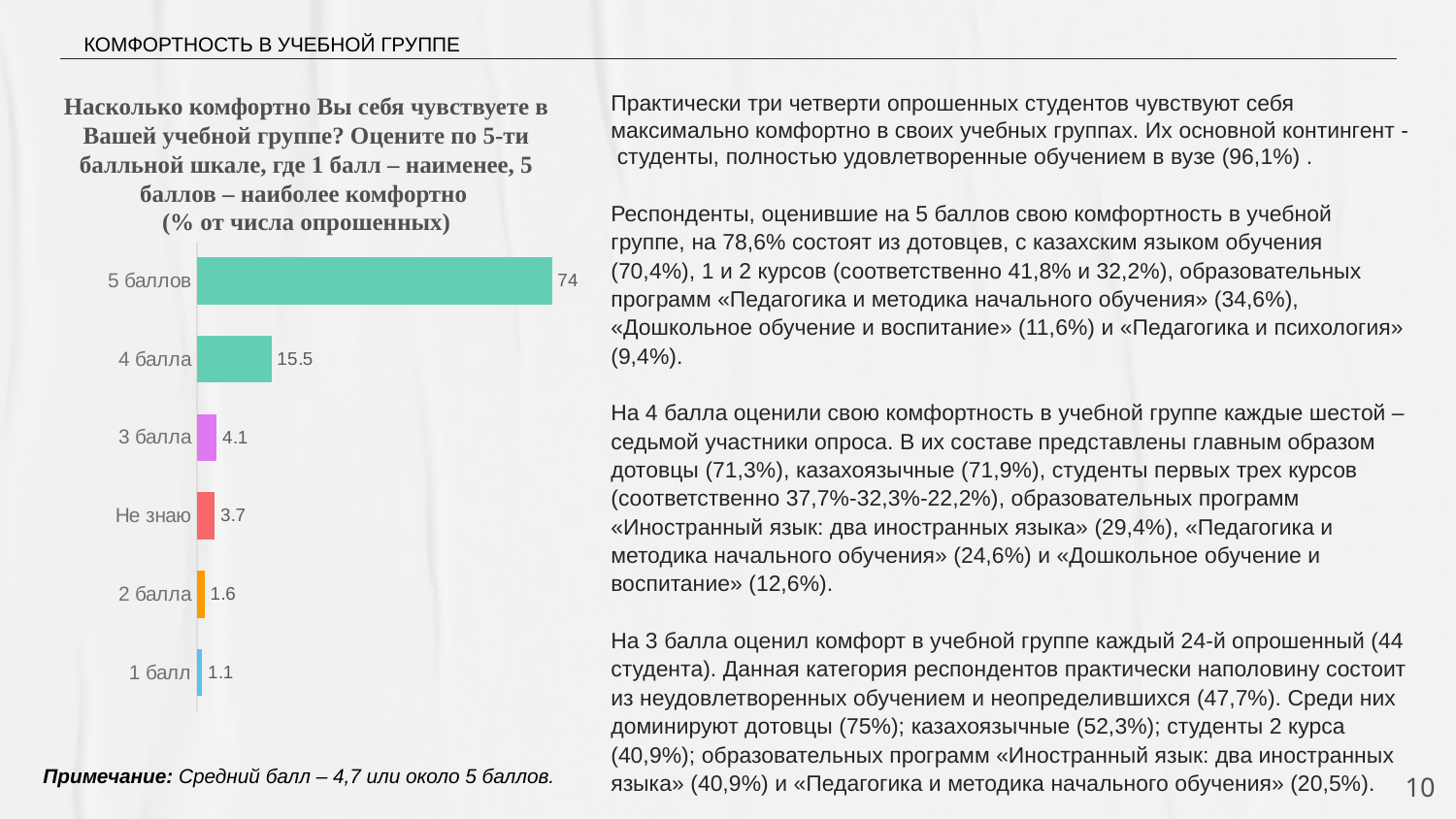
What is the difference between the values for "5 баллов" and "4 балла"? 58.5 Which category has the lowest value? 1 балл How many categories are shown in the chart? 6 What is the value for "5 баллов"? 74 What is the difference between the values for "2 балла" and "1 балл"? 0.5 Which category has the highest value? 5 баллов What is the value for "Не знаю"? 3.7 What is the value for "4 балла"? 15.5 What is the value for "1 балл"? 1.1 Which is larger, the value for "3 балла" or the value for "Не знаю"? 3 балла What unit does the chart title say the values are expressed in? % от числа опрошенных What kind of chart is shown on the slide? Bar chart